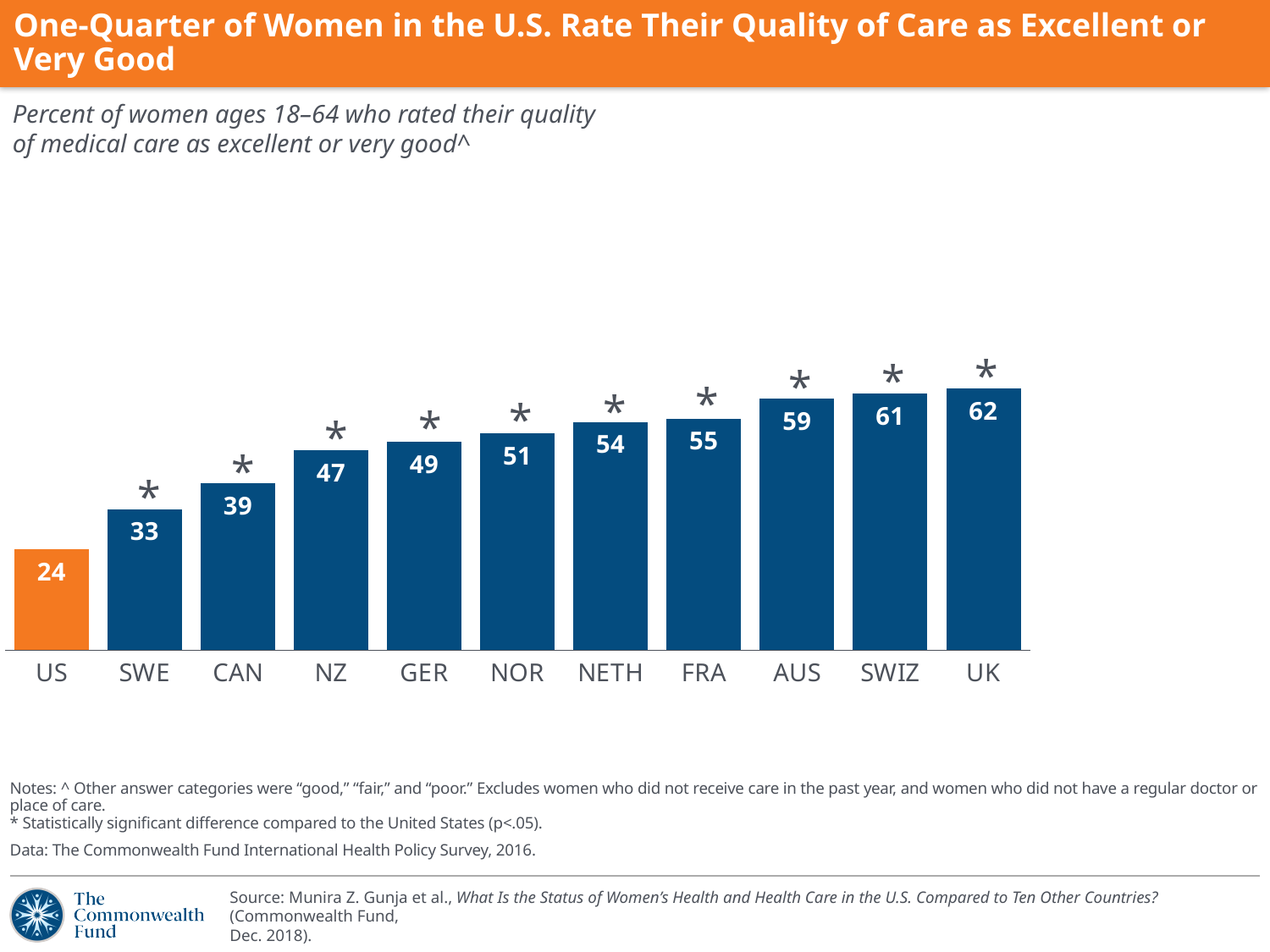
What kind of chart is shown on the slide? bar chart What is the value for SWIZ? 61 How many countries are shown in the chart? 11 Which bar is shown in a different colour (orange) from the others? US What is the difference between the values for UK and US? 38 Which country has the lowest value? US Which is larger, the value for NOR or the value for NZ? NOR What is the value for GER? 49 Do the values rise or fall from left to right across the countries? rise What is the difference between the values for CAN and SWE? 6 Which country has the highest value? UK What is the value for the US? 24